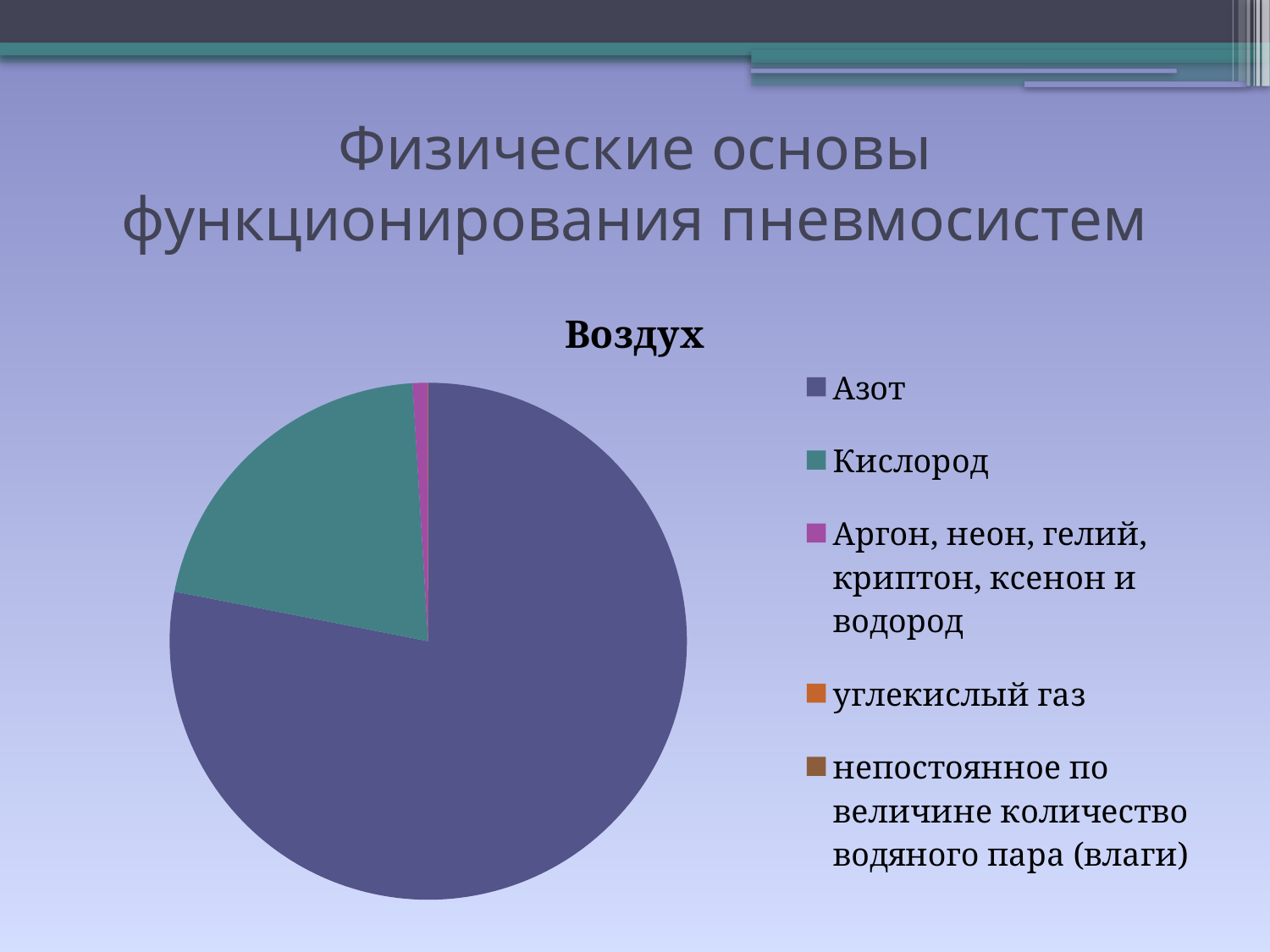
Which category has the second-largest slice of the pie? Кислород What kind of chart is shown on the slide? pie chart Which slice is larger, Азот or Кислород? Азот Which category has the largest slice of the pie? Азот What is the title of the chart? Воздух What colour is the slice for Кислород? teal (green) Which slice is larger, Кислород or Аргон, неон, гелий, криптон, ксенон и водород? Кислород Does the slice for Азот take up more or less than half of the pie? more How many categories does the chart's legend list? 5